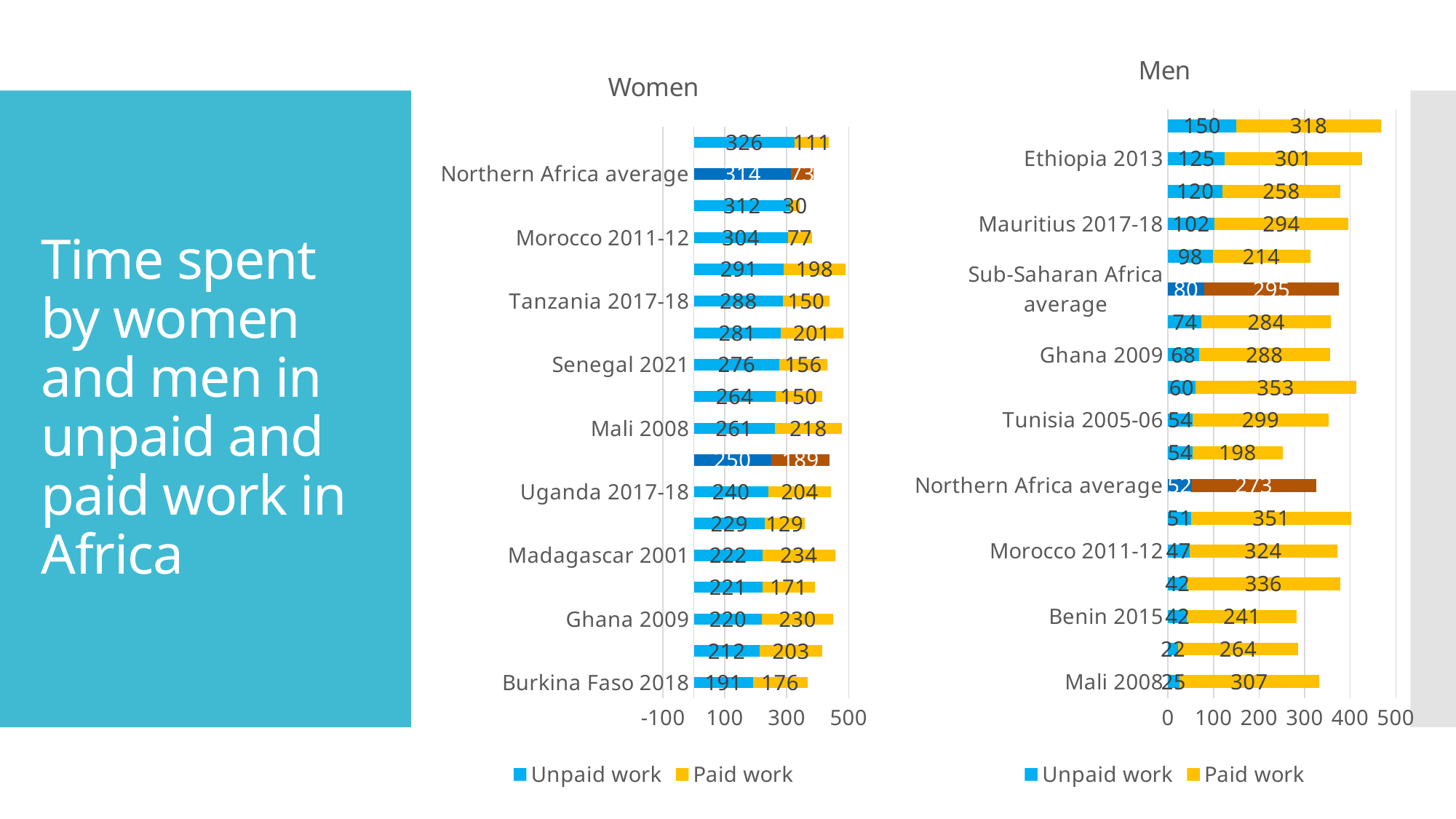
What kind of chart is the Women chart? Stacked bar chart On the Women chart, what is the total of the stacked bar for Burkina Faso 2018? 367 On the Men chart, what is the unpaid work value for Mauritius 2017-18? 102 On the Women chart, what is the paid work value for Mali 2008? 218 On the Men chart, what is the paid work value for Ethiopia 2013? 301 What are the titles of the two charts on the slide? Women and Men On the Men chart, which is larger, the paid work value for Morocco 2011-12 or for Benin 2015? Morocco 2011-12 On the Women chart, which is larger, the unpaid work value for Tanzania 2017-18 or for Uganda 2017-18? Tanzania 2017-18 On the Women chart, what is the difference between the unpaid work values for Northern Africa average and Ghana 2009? 94 How many series does the legend of the Men chart list? 2 On the Men chart, what is the total of the stacked bar for Sub-Saharan Africa average? 375 On the Women chart, what is the unpaid work value for Morocco 2011-12? 304